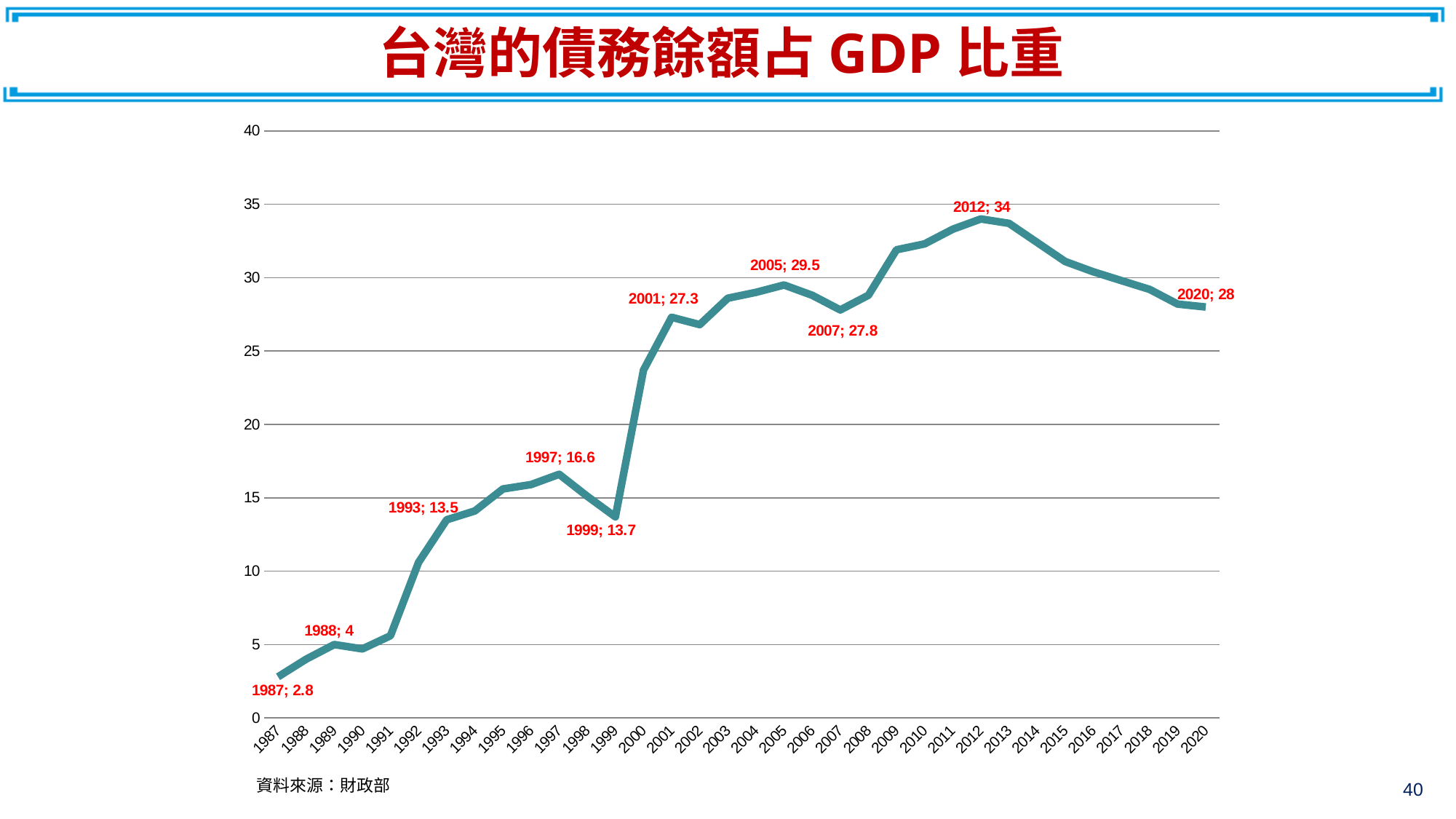
What is the difference between the values for 1997 and 1993? 3.1 What is the value for 2012? 34 Which year has the lowest value on the chart? 1987 Which year has the highest value on the chart? 2012 How many years are shown on the x axis? 34 What is the value for 1987? 2.8 What kind of chart is shown on the slide? line chart What is the difference between the values for 2012 and 2020? 6 What is the value for 2005? 29.5 What is the value for 1999? 13.7 Which is larger, the value for 2001 or the value for 2007? 2007 Is the value for 2000 greater or less than 20? greater